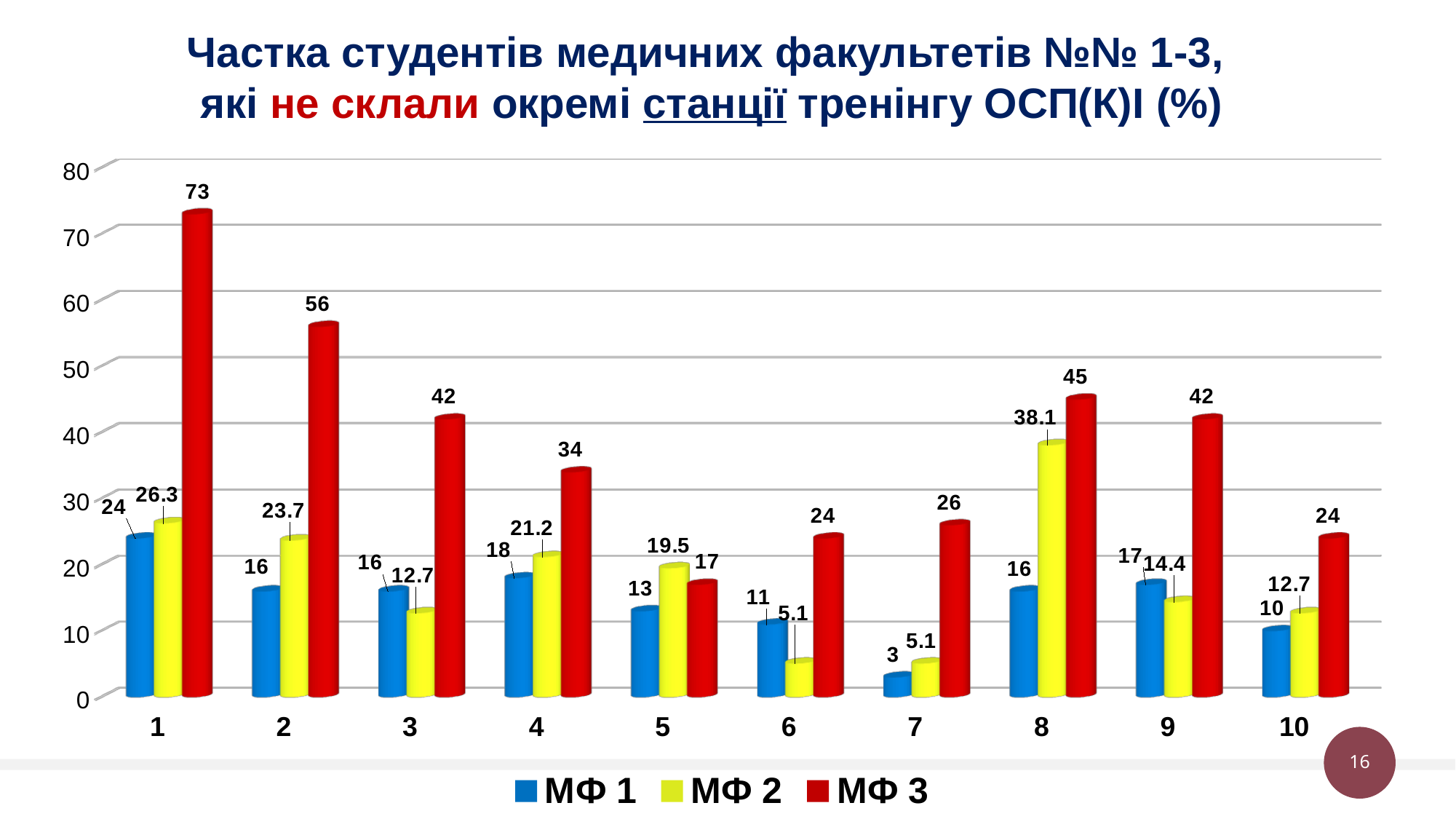
At which station is the МФ 1 value the lowest? 7 What is the difference between the МФ 3 and МФ 1 values at station 2? 40 What is the value for МФ 3 at station 1? 73 Which is larger at station 5: the МФ 2 value or the МФ 3 value? МФ 2 Which colour represents МФ 3 in the chart? red How many stations (categories) are shown on the x axis? 10 Is the value for МФ 3 at station 8 greater or less than 40? greater How many series does the legend list? 3 What is the value for МФ 1 at station 7? 3 What is the value for МФ 2 at station 8? 38.1 What kind of chart is shown on the slide? bar chart At which station is the МФ 3 value the highest? 1